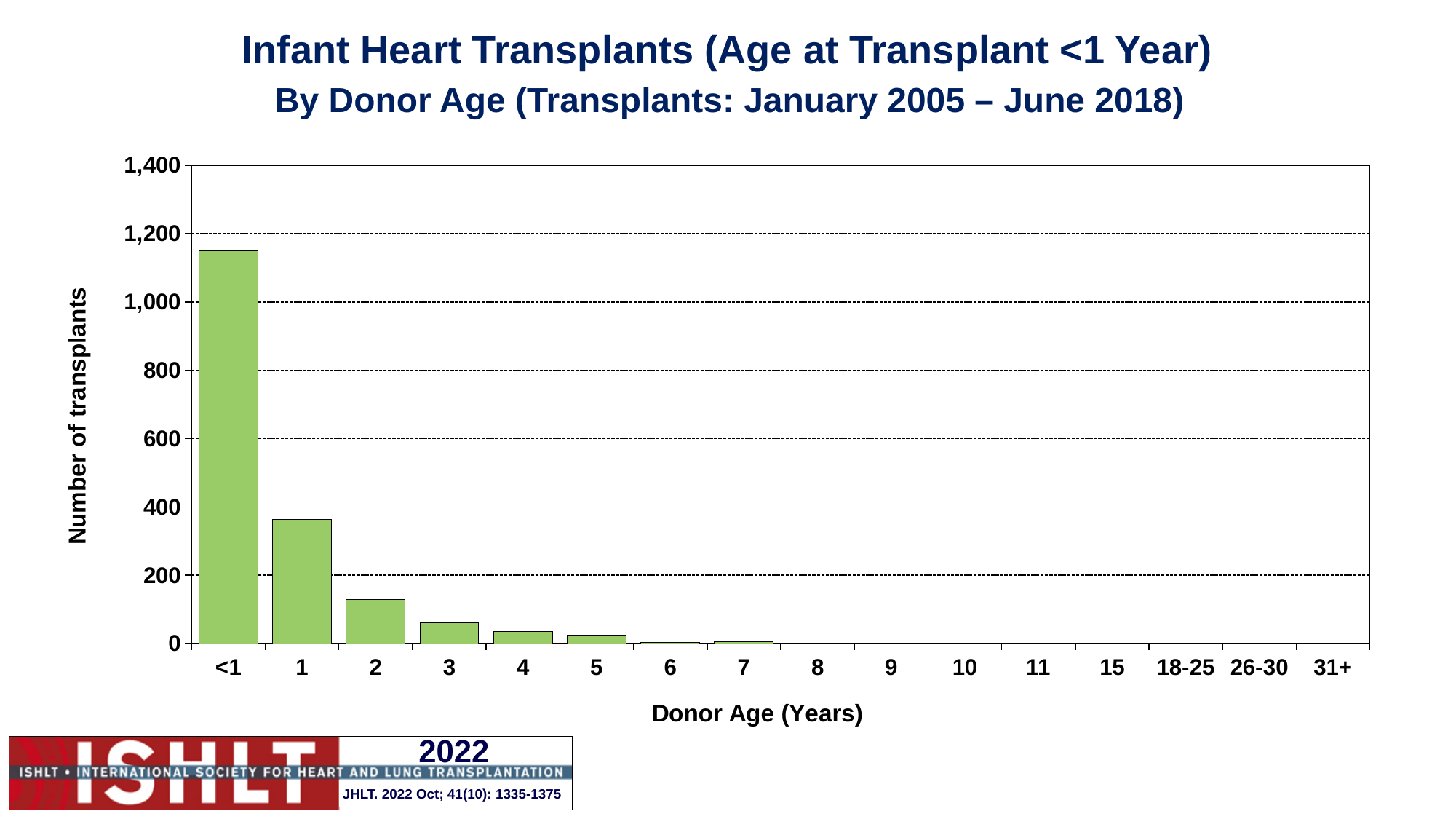
Which has more transplants: donor age 2 or donor age 3? 2 Is the number of transplants for donor age 1 greater or less than 400? less What kind of chart is shown on the slide? bar chart Is the number of transplants for donor age 1 greater or less than 200? greater Is the number of transplants for donor age <1 greater or less than 1,000? greater What is the label of the x axis? Donor Age (Years) Do the number of transplants rise or fall as donor age increases along the x axis? fall Which donor age category has the highest number of transplants? <1 How many donor age categories are shown on the x axis? 16 What is the label of the y axis? Number of transplants Which has more transplants: donor age <1 or donor age 1? <1